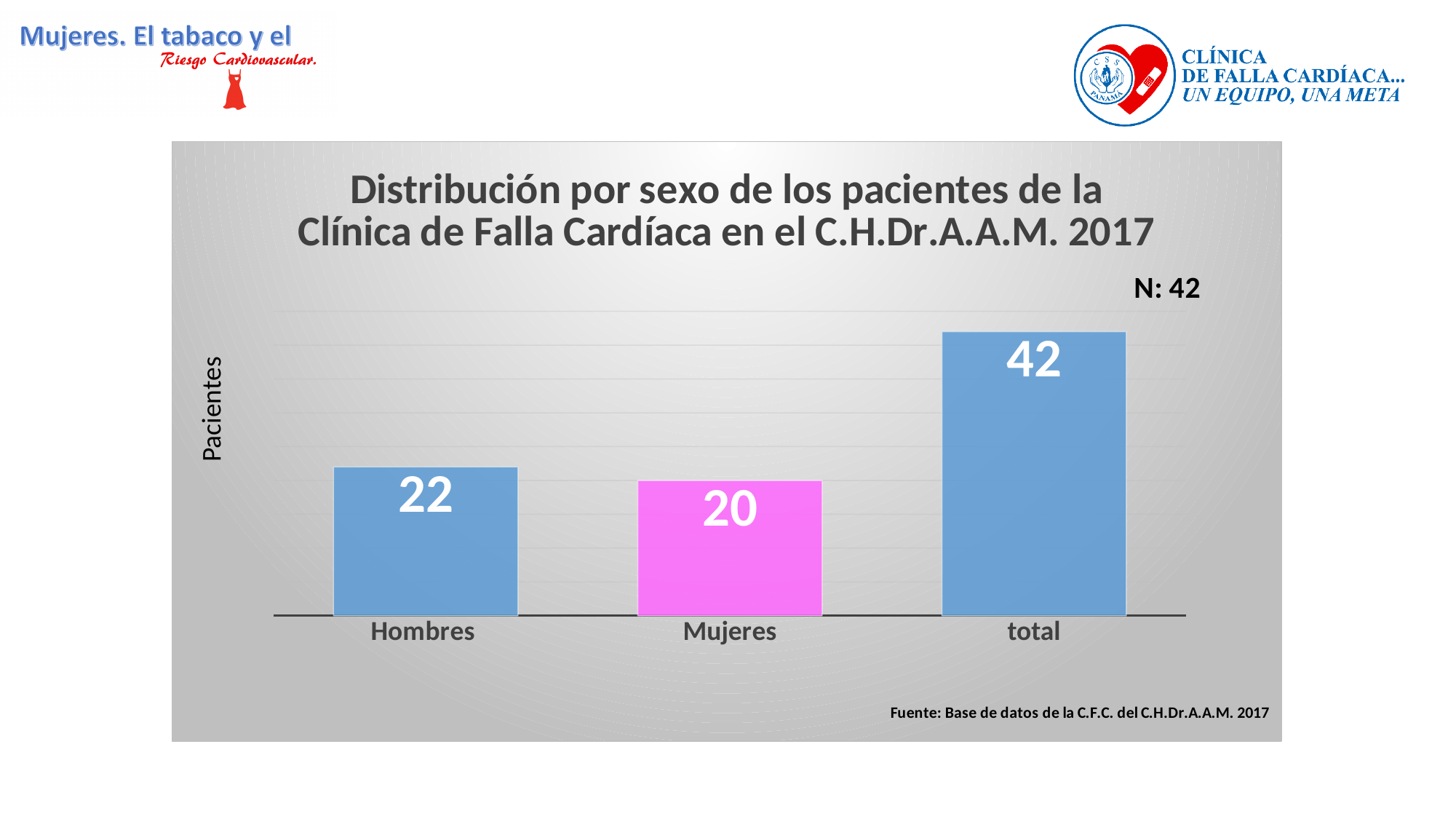
What is the value for Hombres? 22 What is the value for total? 42 What is the difference between the values for Hombres and Mujeres? 2 How many categories are shown on the x axis? 3 Which is larger, the value for Hombres or the value for Mujeres? Hombres What is the title of the chart? Distribución por sexo de los pacientes de la Clínica de Falla Cardíaca en el C.H.Dr.A.A.M. 2017 What is the value for Mujeres? 20 What is the difference between the values for total and Hombres? 20 What kind of chart is shown on the slide? bar chart Which category has the highest value? total What is the label of the y axis? Pacientes Which category has the lowest value? Mujeres